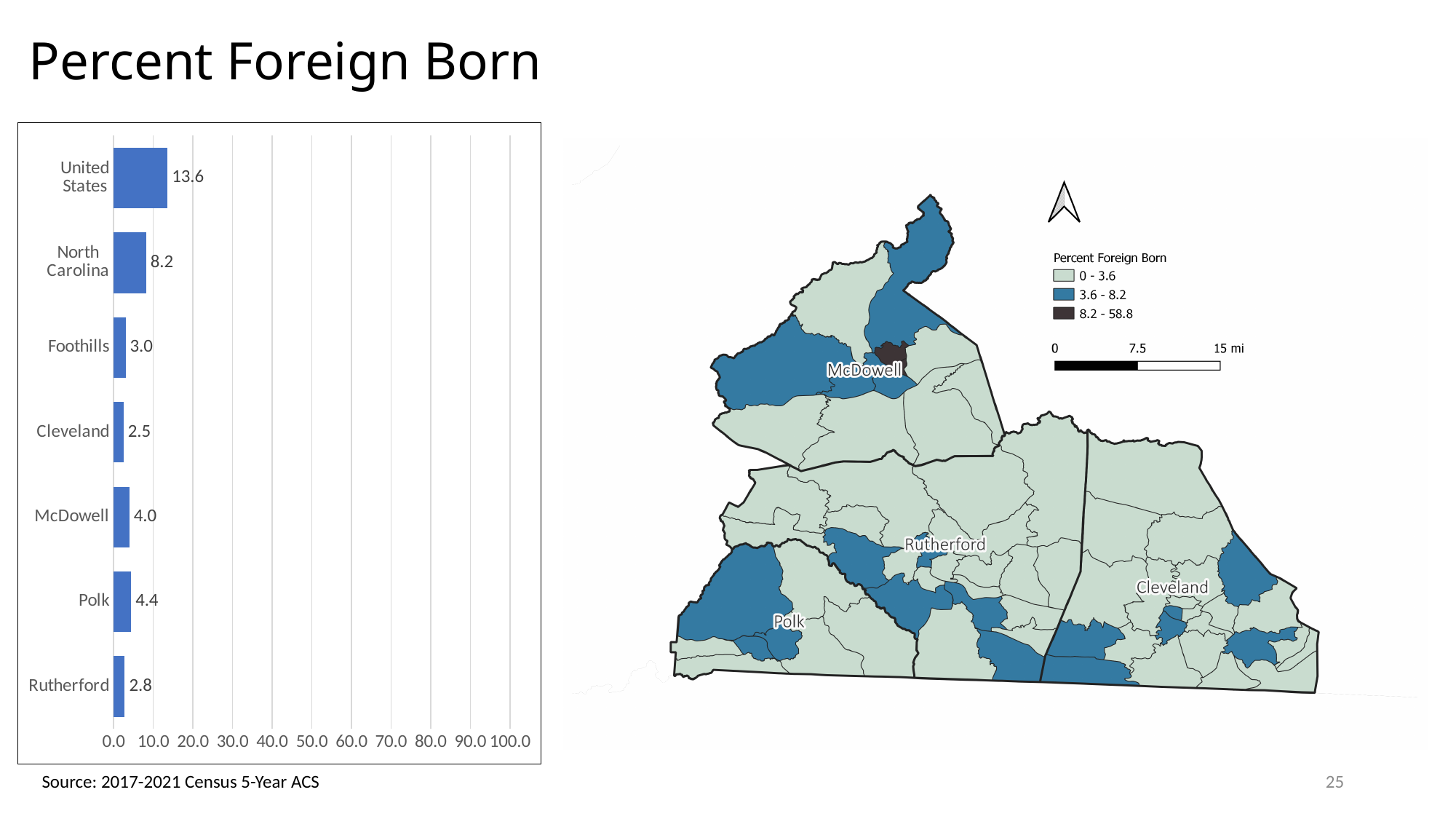
Which category has the highest value in the bar chart? United States Which has a larger value in the bar chart, Polk or McDowell? Polk How many categories are shown in the bar chart? 7 Which category has the lowest value in the bar chart? Cleveland What is the percent foreign born value for Rutherford in the bar chart? 2.8 What is the highest value on the x axis of the bar chart? 100.0 What is the difference between the United States and North Carolina values in the bar chart? 5.4 What is the percent foreign born value for North Carolina in the bar chart? 8.2 What kind of chart is shown on the left of the slide? Bar chart Is the value for North Carolina in the bar chart greater or less than 10.0? less What is the percent foreign born value for the United States in the bar chart? 13.6 What is the percent foreign born value for McDowell in the bar chart? 4.0